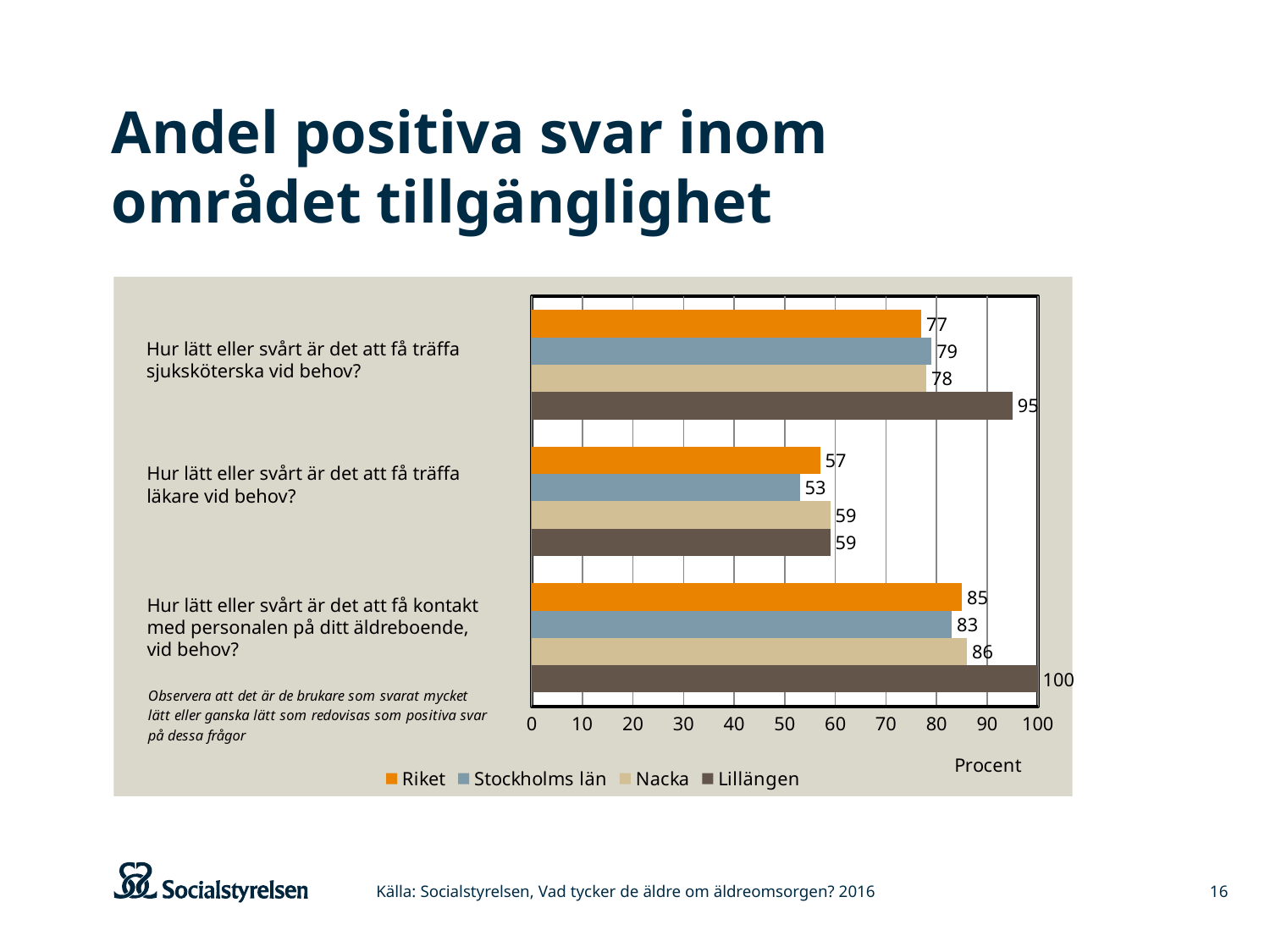
What is the value for Nacka on the question about contacting staff at the care home ("Hur lätt eller svårt är det att få kontakt med personalen på ditt äldreboende, vid behov?")? 86 What is the value for Lillängen on the question about meeting a nurse when needed ("Hur lätt eller svårt är det att få träffa sjuksköterska vid behov?")? 95 Which series is shown in orange in the legend? Riket How many series does the legend list? 4 Which series has the highest value on the question about contacting staff at the care home? Lillängen Which is larger on the question about meeting a doctor when needed: Riket or Stockholms län? Riket What is the label of the horizontal axis? Procent What kind of chart is shown on the slide? Bar chart What is the difference between Lillängen and Riket on the question about meeting a nurse when needed? 18 How many question categories are shown on the chart? 3 What is the value for Stockholms län on the question about meeting a doctor when needed ("Hur lätt eller svårt är det att få träffa läkare vid behov?")? 53 Which series has the lowest value on the question about meeting a doctor when needed? Stockholms län